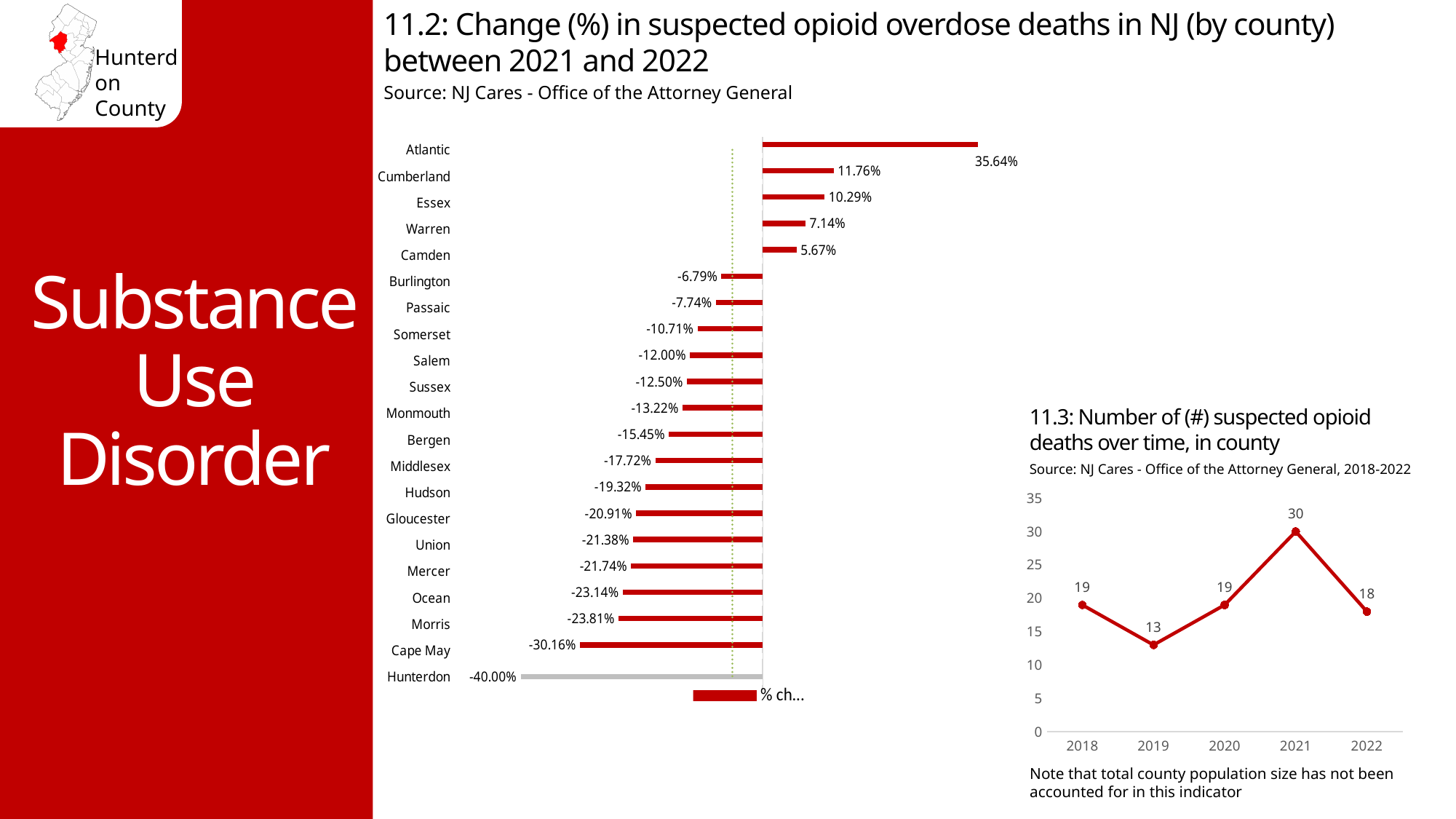
In chart 11.3, what is the difference in suspected opioid deaths between 2021 and 2022? 12 In chart 11.2, which county has the highest change (%) in suspected opioid overdose deaths? Atlantic In chart 11.3, how many suspected opioid deaths were there in 2021? 30 What kind of chart is chart 11.3? Line chart In chart 11.2, what is the change (%) in suspected opioid overdose deaths for Atlantic county? 35.64% What kind of chart is chart 11.2? Bar chart In chart 11.2, which county has the lowest change (%) in suspected opioid overdose deaths? Hunterdon In chart 11.2, what is the change (%) in suspected opioid overdose deaths for Hunterdon county? -40.00% In chart 11.2, what is the difference between the values for Cumberland and Essex? 1.47% In chart 11.3, which year has the lowest number of suspected opioid deaths? 2019 In chart 11.2, which county has a larger change (%): Cape May or Morris? Morris In chart 11.2, how many counties are shown? 21